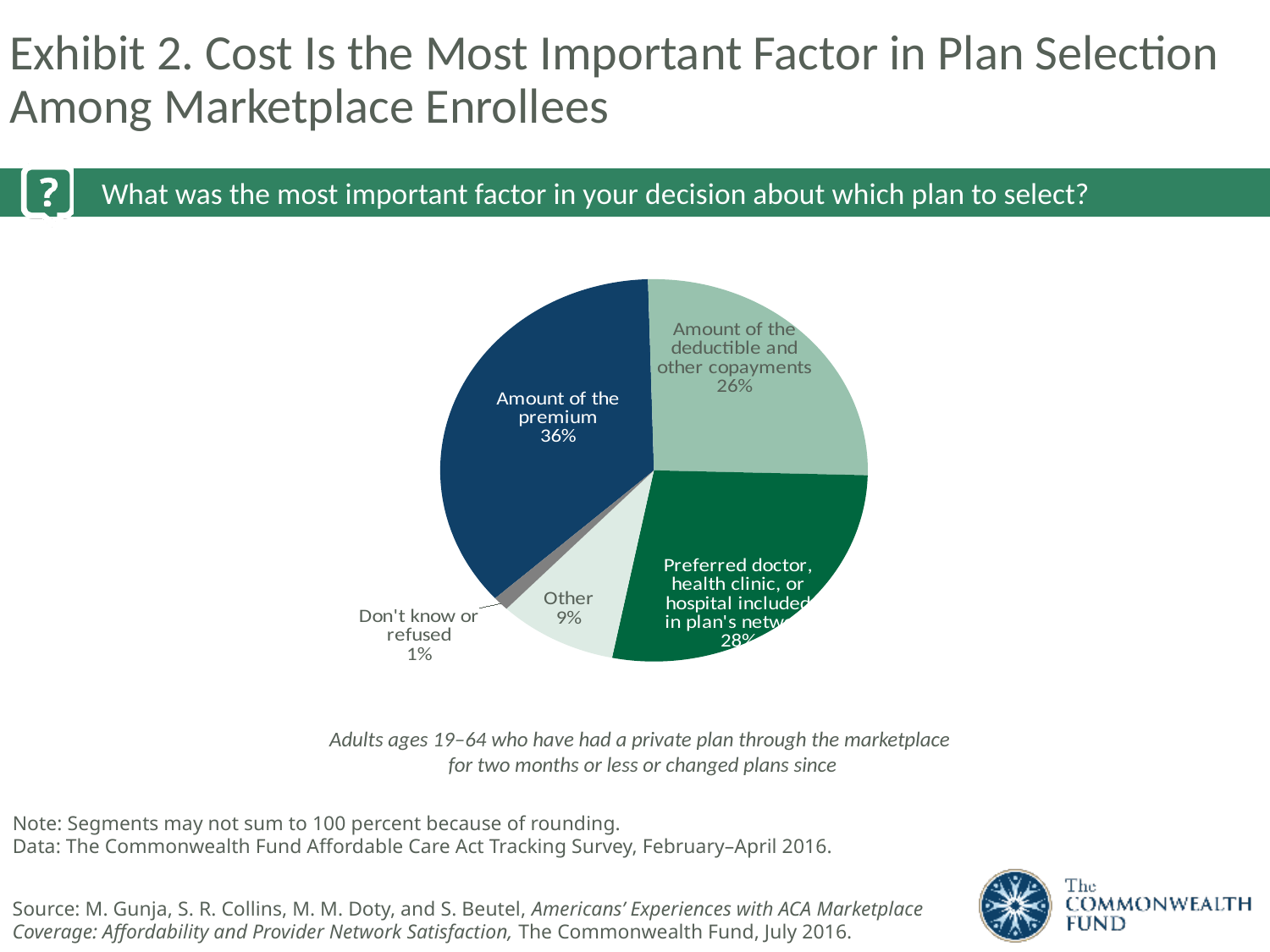
Which is larger: the share for preferred doctor, health clinic, or hospital in the plan's network, or the share for the amount of the deductible and other copayments? Preferred doctor, health clinic, or hospital included in plan's network Which category has the smallest slice of the pie? Don't know or refused How many slices does the pie chart have? 5 What share of respondents said the amount of the premium was the most important factor? 36% What share of respondents answered 'Other'? 9% What kind of chart is shown on the slide? Pie chart What survey question is shown in the green banner above the chart? What was the most important factor in your decision about which plan to select? What share of respondents chose the amount of the deductible and other copayments? 26% What percentage of respondents said they don't know or refused? 1% What is the difference in percentage points between the amount of the premium and the amount of the deductible and other copayments? 10 percentage points Which factor has the largest slice of the pie? Amount of the premium What percentage of respondents said a preferred doctor, health clinic, or hospital included in the plan's network was the most important factor? 28%